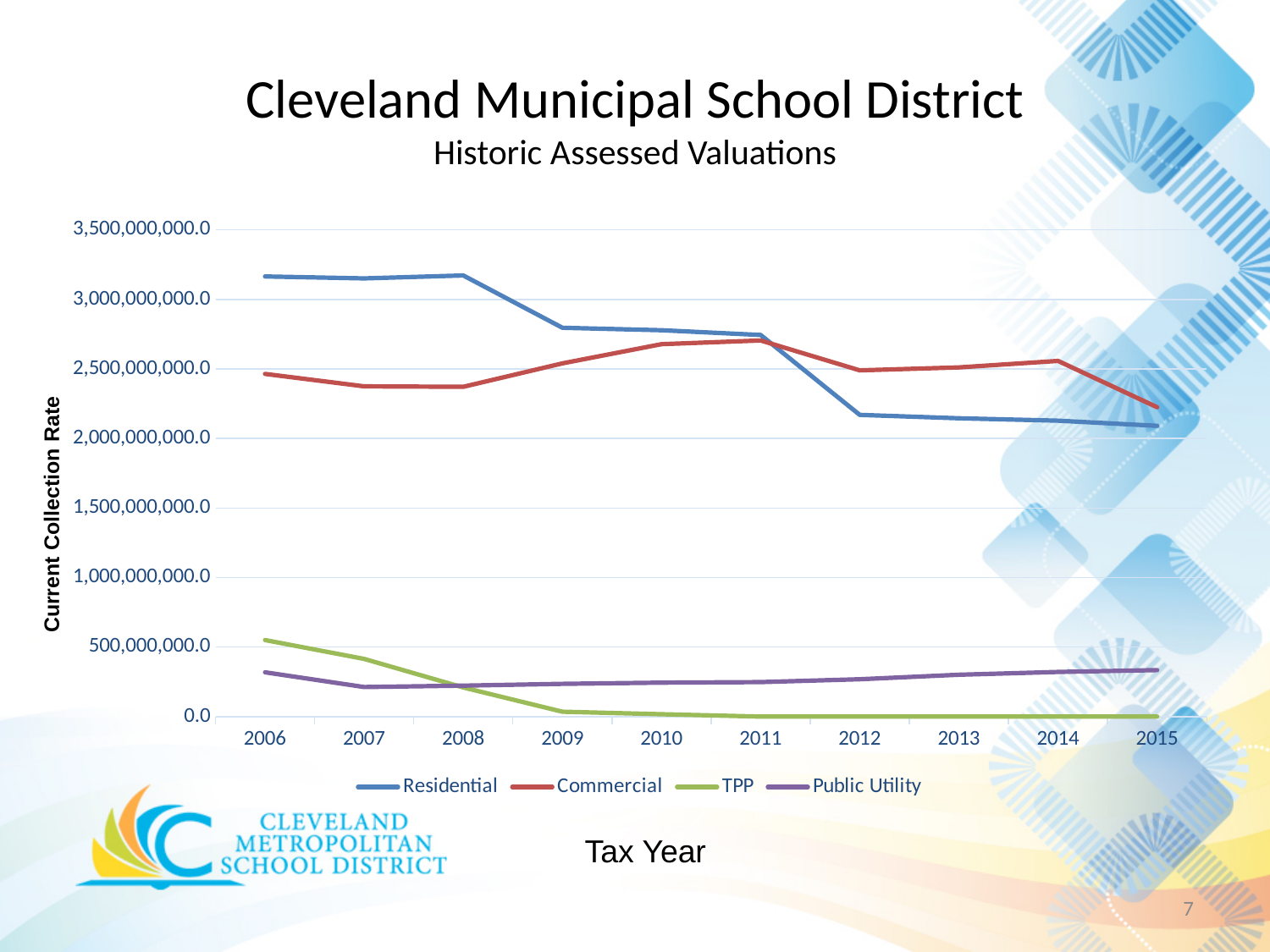
Is the Commercial value for 2010 greater or less than 2,500,000,000.0? greater In 2015, which is larger, the Residential value or the Commercial value? Commercial In 2006, which is larger, the Residential value or the Commercial value? Residential How many tax years are plotted along the x axis? 10 How many series does the legend list? 4 Is the Residential value for 2006 greater or less than 3,000,000,000.0? greater Does the Residential series rise or fall from 2006 to 2015? Fall Is the Residential value for 2015 greater or less than 2,500,000,000.0? less Which series has the lowest value in 2015? TPP What kind of chart is shown on the slide? Line chart Does the TPP series rise or fall from 2006 to 2015? Fall